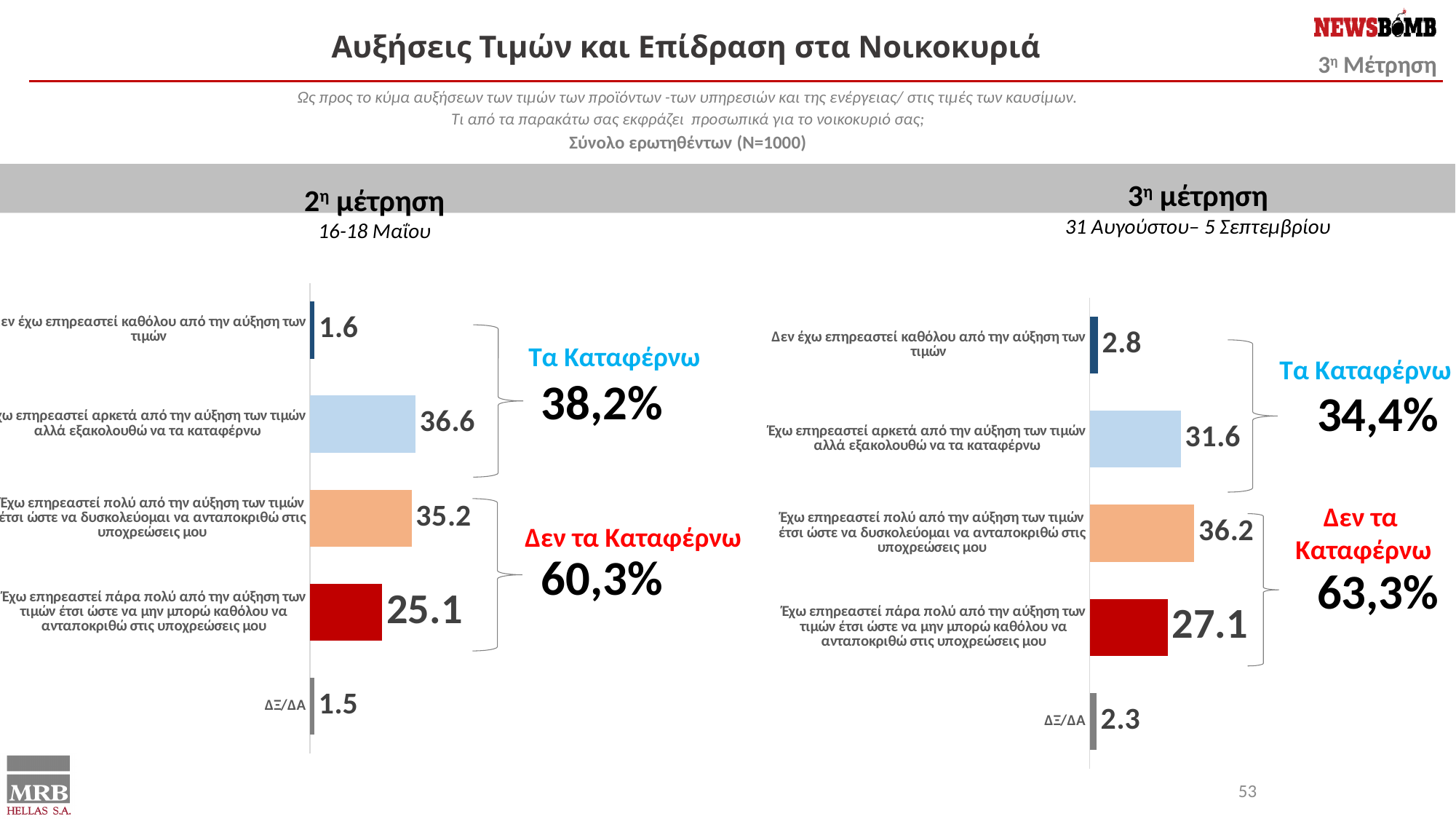
In the 3η μέτρηση chart, what is the value for 'Έχω επηρεαστεί πάρα πολύ από την αύξηση των τιμών έτσι ώστε να μην μπορώ καθόλου να ανταποκριθώ στις υποχρεώσεις μου'? 27.1 What is the difference between the 'Έχω επηρεαστεί πάρα πολύ' value in the 3η μέτρηση chart and the same category in the 2η μέτρηση chart? 2.0 In the 2η μέτρηση chart, which category has the lowest value? ΔΞ/ΔΑ How many categories are plotted in the 2η μέτρηση chart? 5 In the 2η μέτρηση chart, what is the value for 'Έχω επηρεαστεί αρκετά από την αύξηση των τιμών αλλά εξακολουθώ να τα καταφέρνω'? 36.6 In the 3η μέτρηση chart, what is the value for ΔΞ/ΔΑ? 2.3 In the 3η μέτρηση chart, which category has the highest value? Έχω επηρεαστεί πολύ από την αύξηση των τιμών έτσι ώστε να δυσκολεύομαι να ανταποκριθώ στις υποχρεώσεις μου What type of chart is used for the 3η μέτρηση data? Bar chart In the 3η μέτρηση chart, which is larger: the value for 'Έχω επηρεαστεί αρκετά' or the value for 'Έχω επηρεαστεί πολύ'? Έχω επηρεαστεί πολύ In the 2η μέτρηση chart, which category has the highest value? Έχω επηρεαστεί αρκετά από την αύξηση των τιμών αλλά εξακολουθώ να τα καταφέρνω In the 3η μέτρηση chart, what percentage is shown for 'Δεν τα Καταφέρνω'? 63,3% In the 2η μέτρηση chart, what percentage is shown for 'Τα Καταφέρνω'? 38,2%